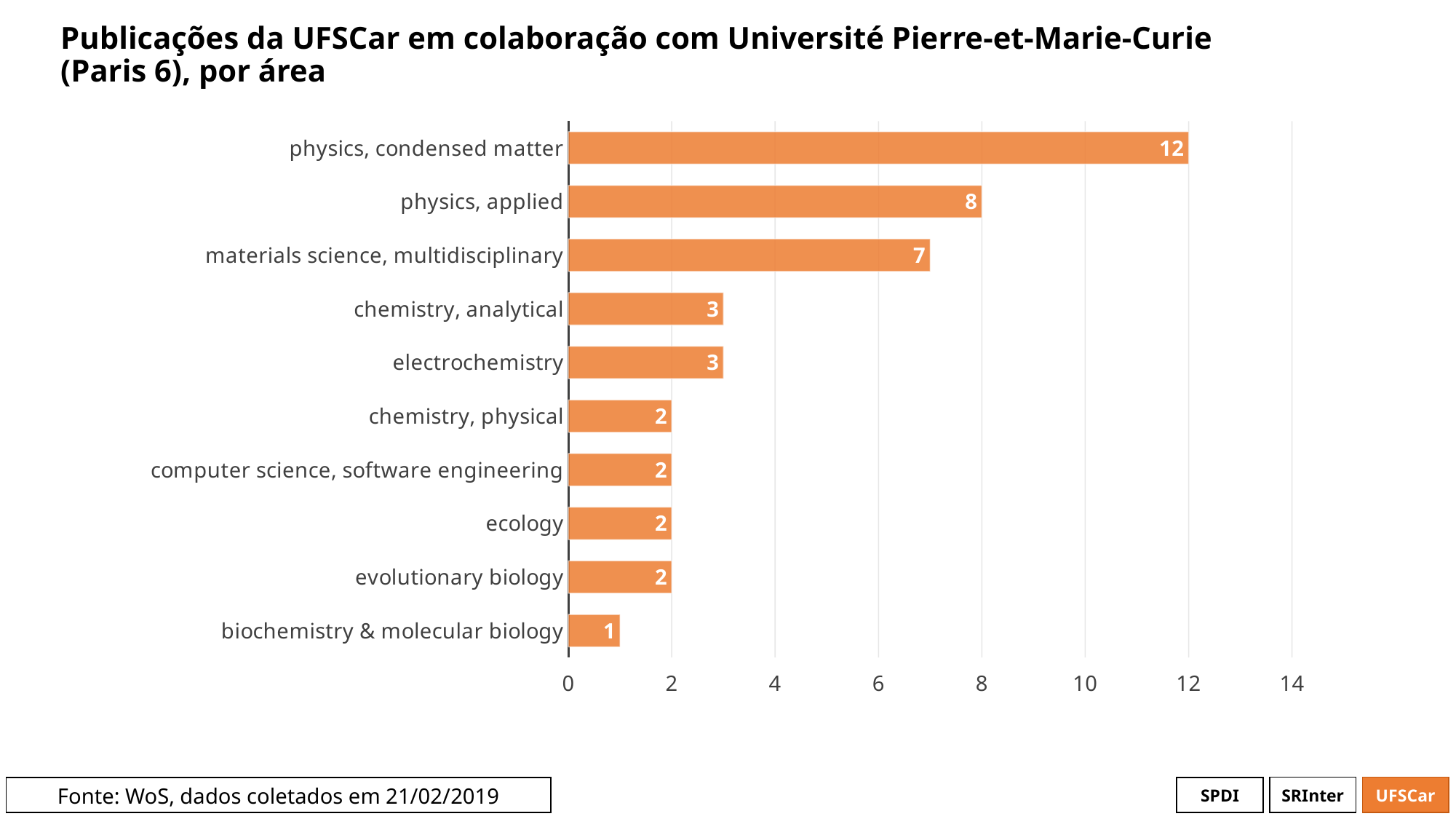
Which area has the lowest number of publications? biochemistry & molecular biology Which area has the highest number of publications? physics, condensed matter What is the data source cited on the slide? WoS, dados coletados em 21/02/2019 What is the value for physics, condensed matter? 12 What is the value for biochemistry & molecular biology? 1 How many areas are shown in the chart? 10 What kind of chart is shown on the slide? bar chart Is the value for physics, condensed matter greater or less than 10? greater What is the value for materials science, multidisciplinary? 7 What is the value for electrochemistry? 3 What is the difference between physics, condensed matter and physics, applied? 4 Which is larger: physics, applied or materials science, multidisciplinary? physics, applied